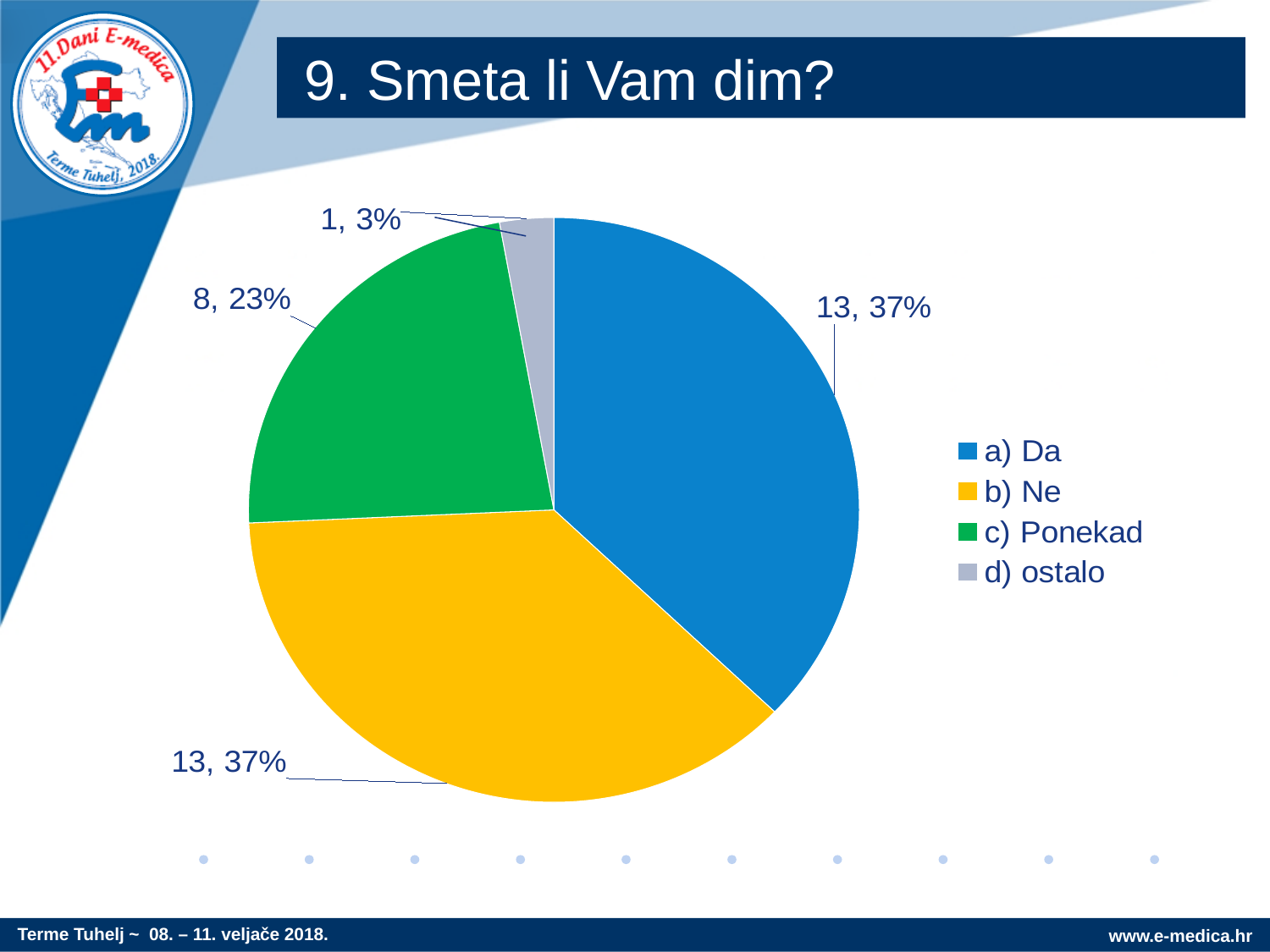
Which category has the smallest slice? d) ostalo Which is larger, c) Ponekad or d) ostalo? c) Ponekad What is the title of the chart? 9. Smeta li Vam dim? What kind of chart is shown on the slide? pie chart How many slices does the pie chart have? 4 What share of the pie does c) Ponekad represent? 23% What is the count for c) Ponekad? 8 What is the total count across all slices of the pie? 35 What share of the pie does a) Da represent? 37% How many entries does the legend list? 4 What is the difference between the counts for b) Ne and c) Ponekad? 5 What is the count for d) ostalo? 1